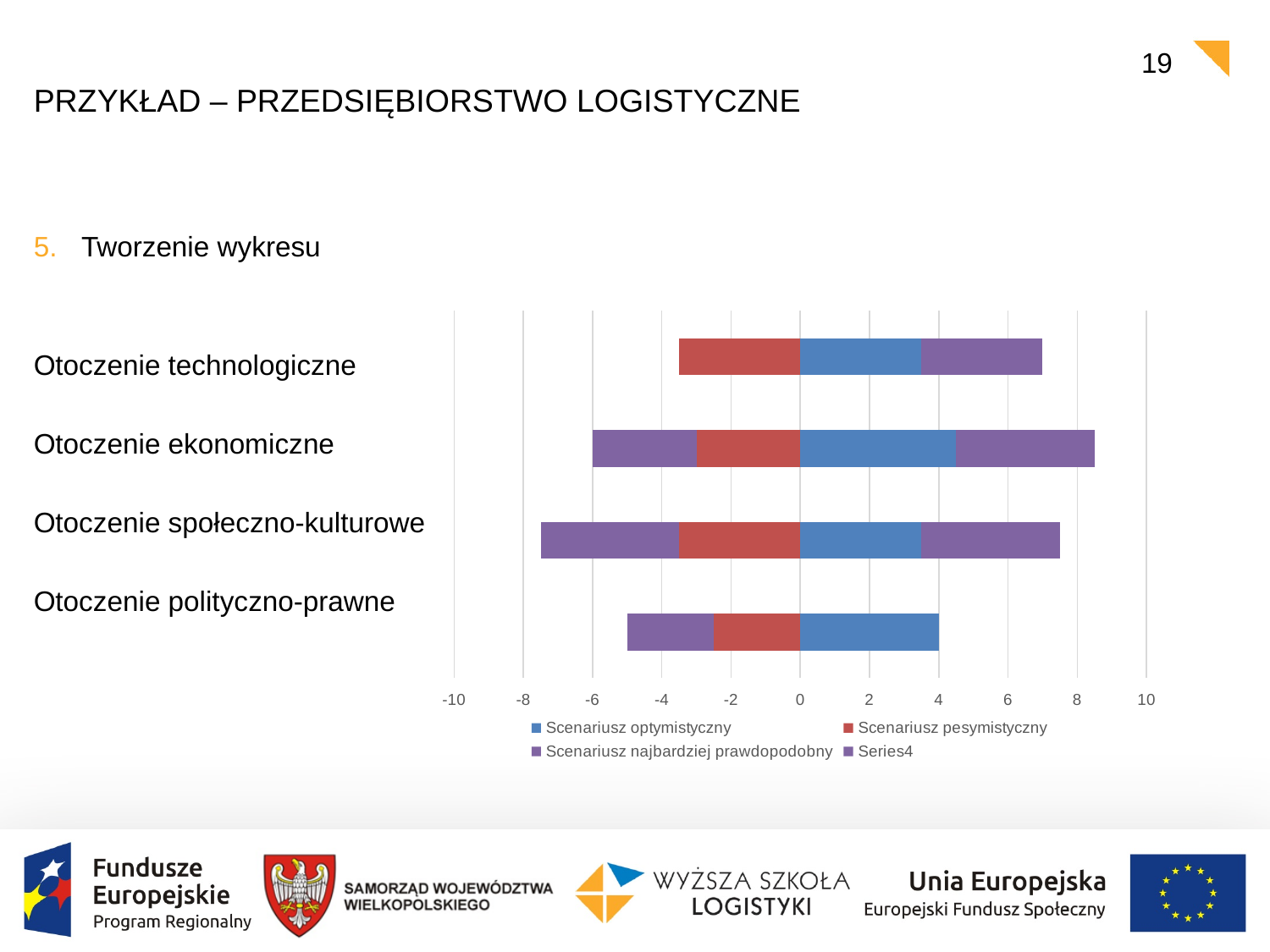
Is the Scenariusz optymistyczny value for Otoczenie ekonomiczne greater or less than 4? greater What are the minimum and maximum values shown on the chart's horizontal axis? -10 and 10 How many series does the chart legend list? 4 Is the Scenariusz optymistyczny value for Otoczenie społeczno-kulturowe greater or less than 2? greater What colour represents Scenariusz pesymistyczny in the chart? red How many categories are plotted on the chart? 4 Which category has the longest Scenariusz optymistyczny bar? Otoczenie ekonomiczne Which has the larger Scenariusz optymistyczny value: Otoczenie ekonomiczne or Otoczenie technologiczne? Otoczenie ekonomiczne Which category has the shortest Scenariusz pesymistyczny bar? Otoczenie polityczno-prawne Is the Scenariusz optymistyczny value for Otoczenie technologiczne greater or less than 4? less What kind of chart is shown on the slide? bar chart